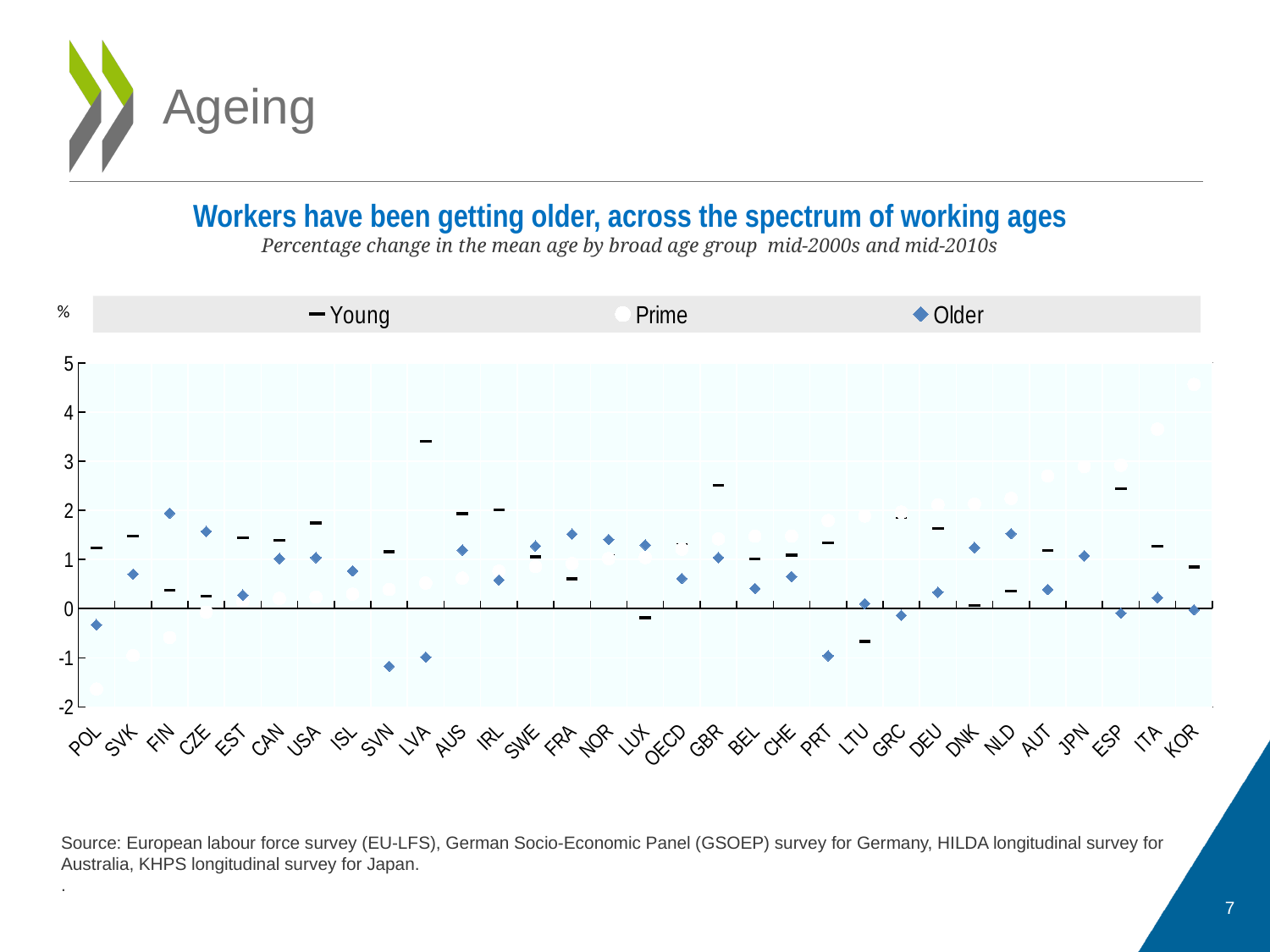
Which is larger: the Young value for LVA or the Young value for GBR? LVA What kind of chart is shown on the slide? Scatter chart How many countries/categories are shown along the x axis? 31 Which marker shape is used for the Older series in the legend? Blue diamond How many series does the legend list? 3 Is the Older value for SVN greater or less than 0? less Which category has the highest value for the Prime series? KOR What is the title of the chart? Workers have been getting older, across the spectrum of working ages Is the Prime value for KOR greater or less than 4? greater Which category has the highest value for the Young series? LVA Is the Young value for LTU greater or less than 0? less